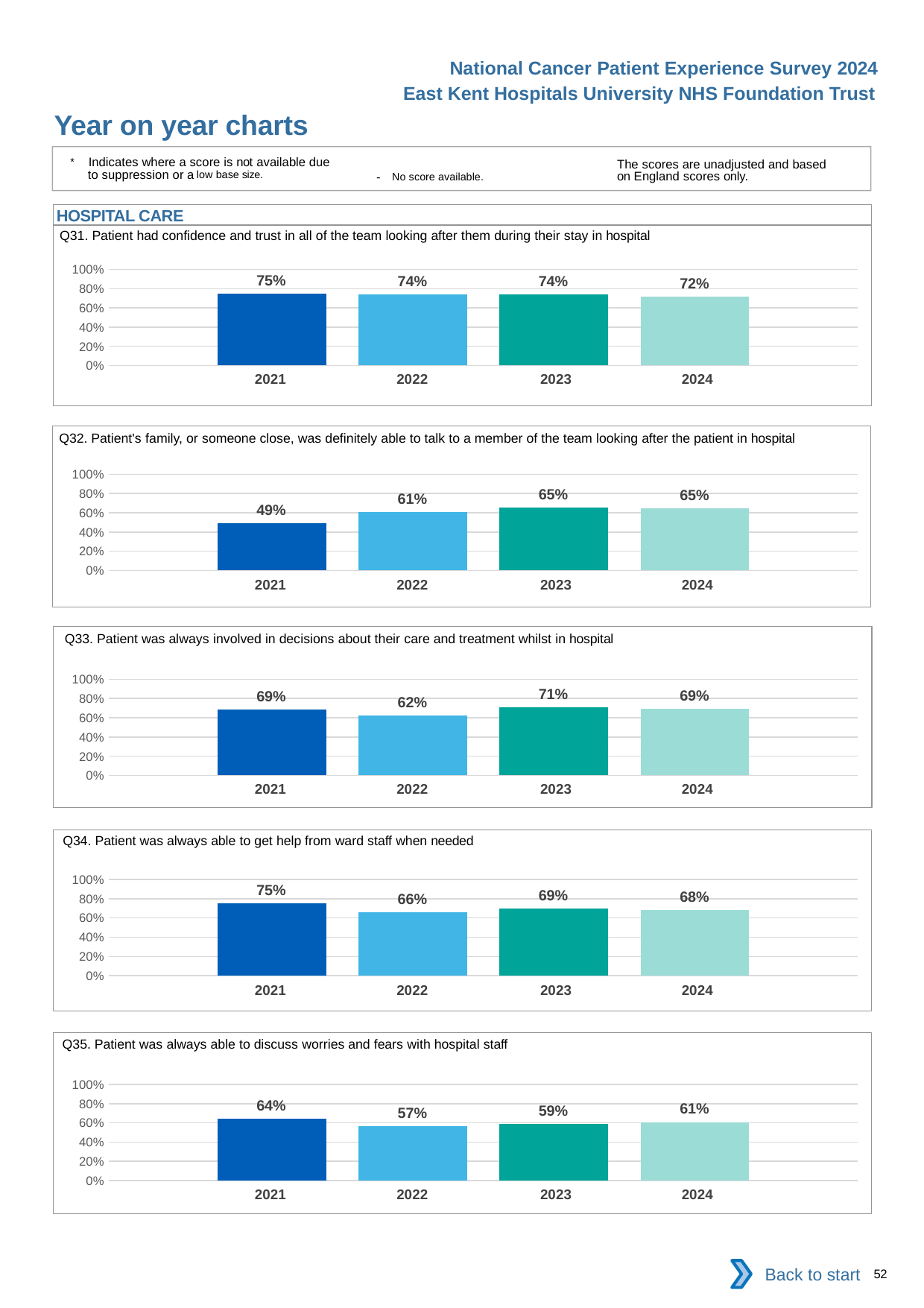
How many years are shown in the Q31 chart? 4 In the Q33 chart, what is the value for 2022? 62% In the Q35 chart, do the values rise or fall from 2022 to 2024? rise In the Q33 chart, which year has the highest value? 2023 In the Q32 chart, what is the difference between the 2021 and 2024 values? 16 percentage points In the Q35 chart, which year has the lowest value? 2022 In the Q34 chart, is the value for 2021 larger or smaller than the value for 2023? larger What kind of chart is the Q32 chart? bar chart In the Q34 chart, what is the difference between the 2021 and 2022 values? 9 percentage points In the Q31 chart, is the value for 2021 greater or less than 60%? greater In the Q32 chart, which year has the lowest value? 2021 In the Q31 chart, what is the value for 2024? 72%